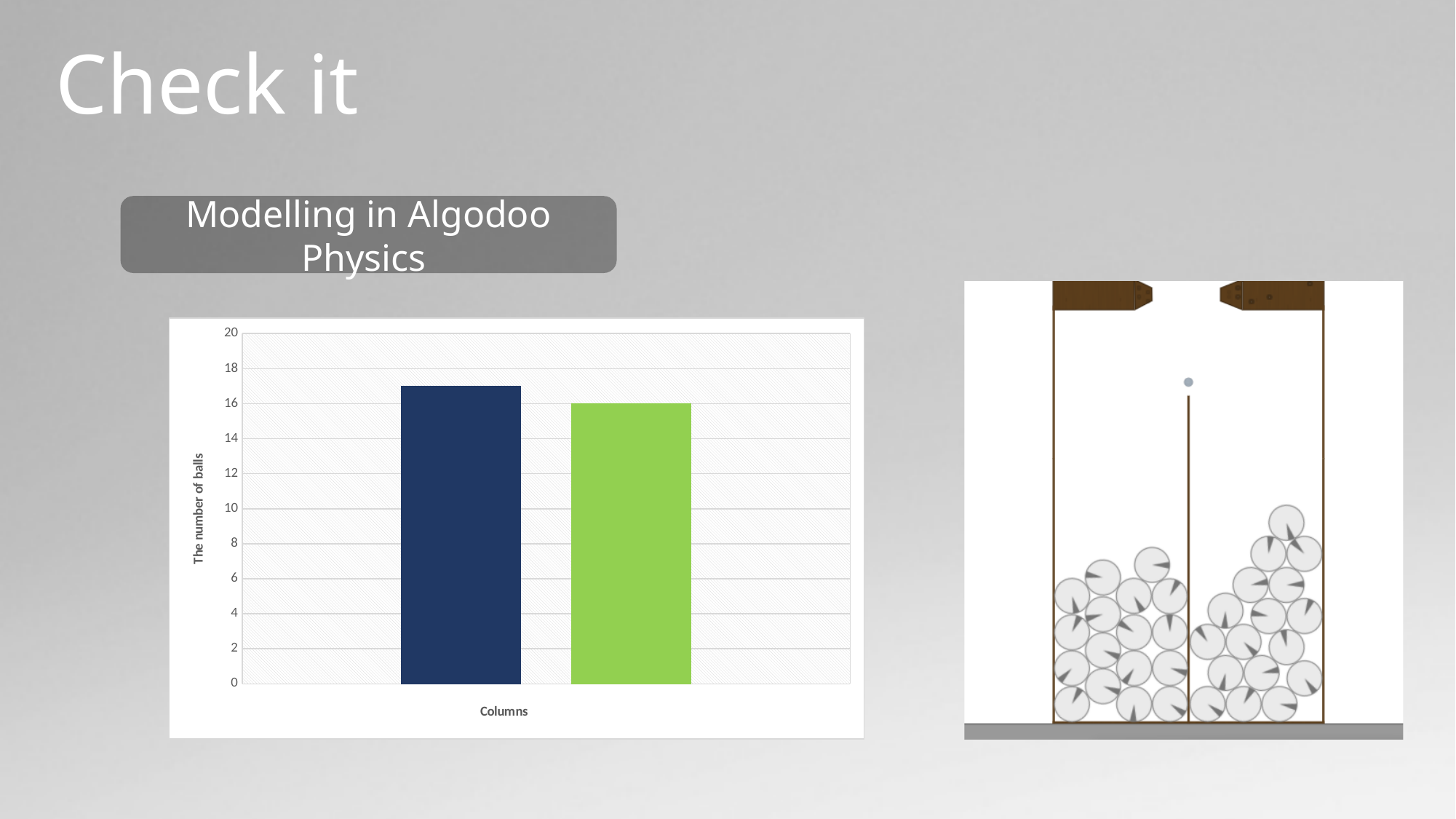
What kind of chart is shown on the slide? bar chart What is the title of the horizontal axis of the chart? Columns Which bar has the highest value on the chart? the dark blue bar Is the value of the dark blue bar greater or less than 16? greater What is the maximum value shown on the vertical axis of the chart? 20 Is the value of the green bar greater or less than 18? less Is the value of the dark blue bar greater or less than 18? less How many bars does the chart show? 2 Which bar has the lowest value on the chart? the green bar What is the title of the vertical axis of the chart? The number of balls What is the value of the green bar on the chart? 16 Which bar is taller, the dark blue bar or the green bar? the dark blue bar